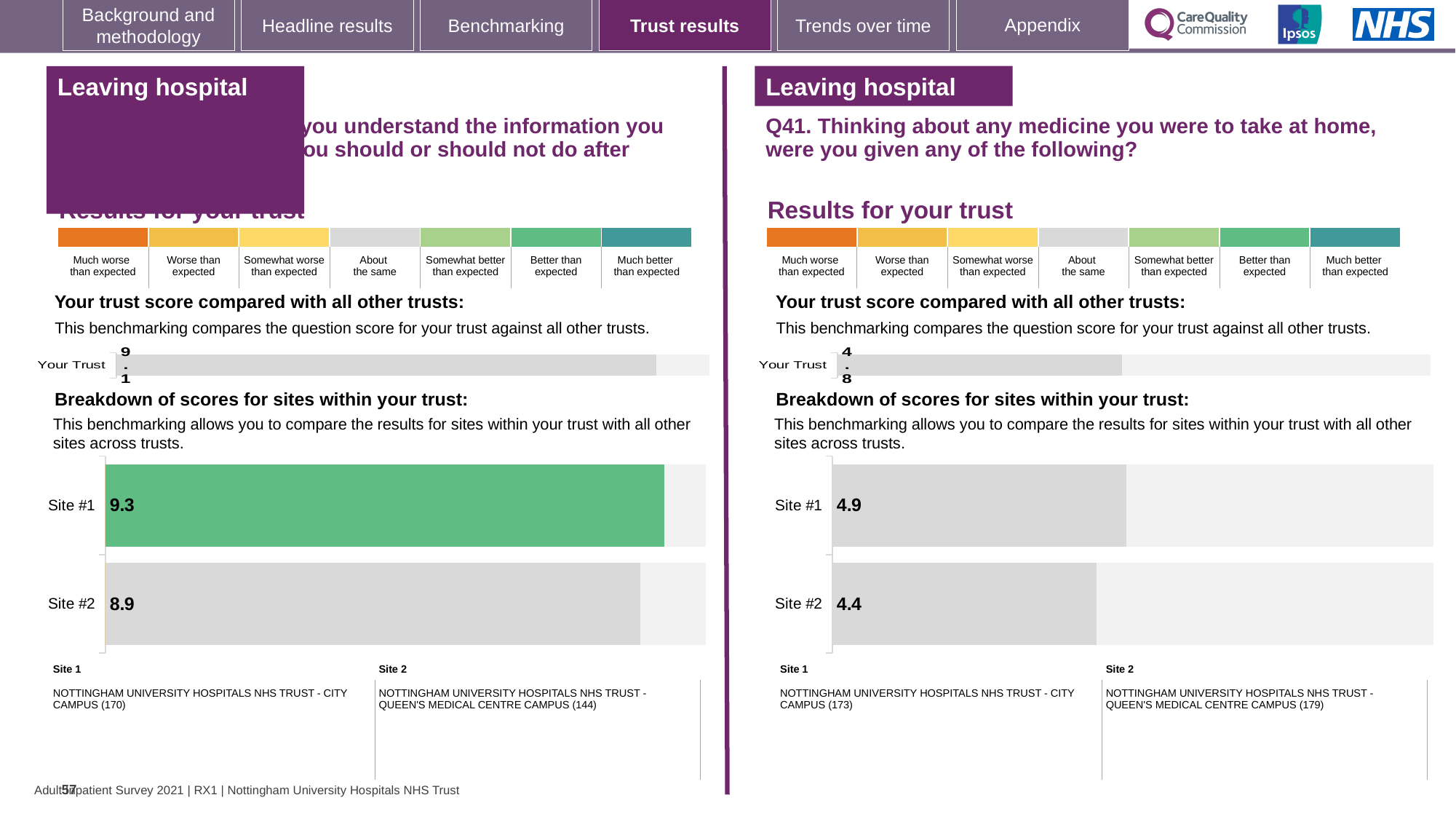
On the left-hand side of the slide, what is the score shown for Site #1 in the breakdown of scores for sites within your trust? 9.3 How many sites are shown in the Q41 site breakdown chart on the right-hand side of the slide? 2 On the left-hand side of the slide, what is the score shown for Site #2 in the breakdown of scores for sites within your trust? 8.9 In the Q41 chart on the right-hand side of the slide, which site has the lower score? Site #2 In the Q41 chart on the right-hand side of the slide, what is the score shown for Site #2? 4.4 On the left-hand side of the slide, what is the 'Your Trust' score shown in the trust benchmarking bar? 9.1 In the Q41 chart on the right-hand side of the slide, what is the score shown for Site #1? 4.9 On the left-hand side of the slide, which site has the higher score in the breakdown of scores for sites within your trust? Site #1 In the Q41 chart on the right-hand side of the slide, what is the difference between the Site #1 and Site #2 scores? 0.5 On the left-hand side of the slide, what is the difference between the Site #1 and Site #2 scores? 0.4 In the Q41 section on the right-hand side of the slide, what is the 'Your Trust' score shown in the trust benchmarking bar? 4.8 What kind of chart is used for the breakdown of scores for sites within your trust on the left-hand side of the slide? Bar chart